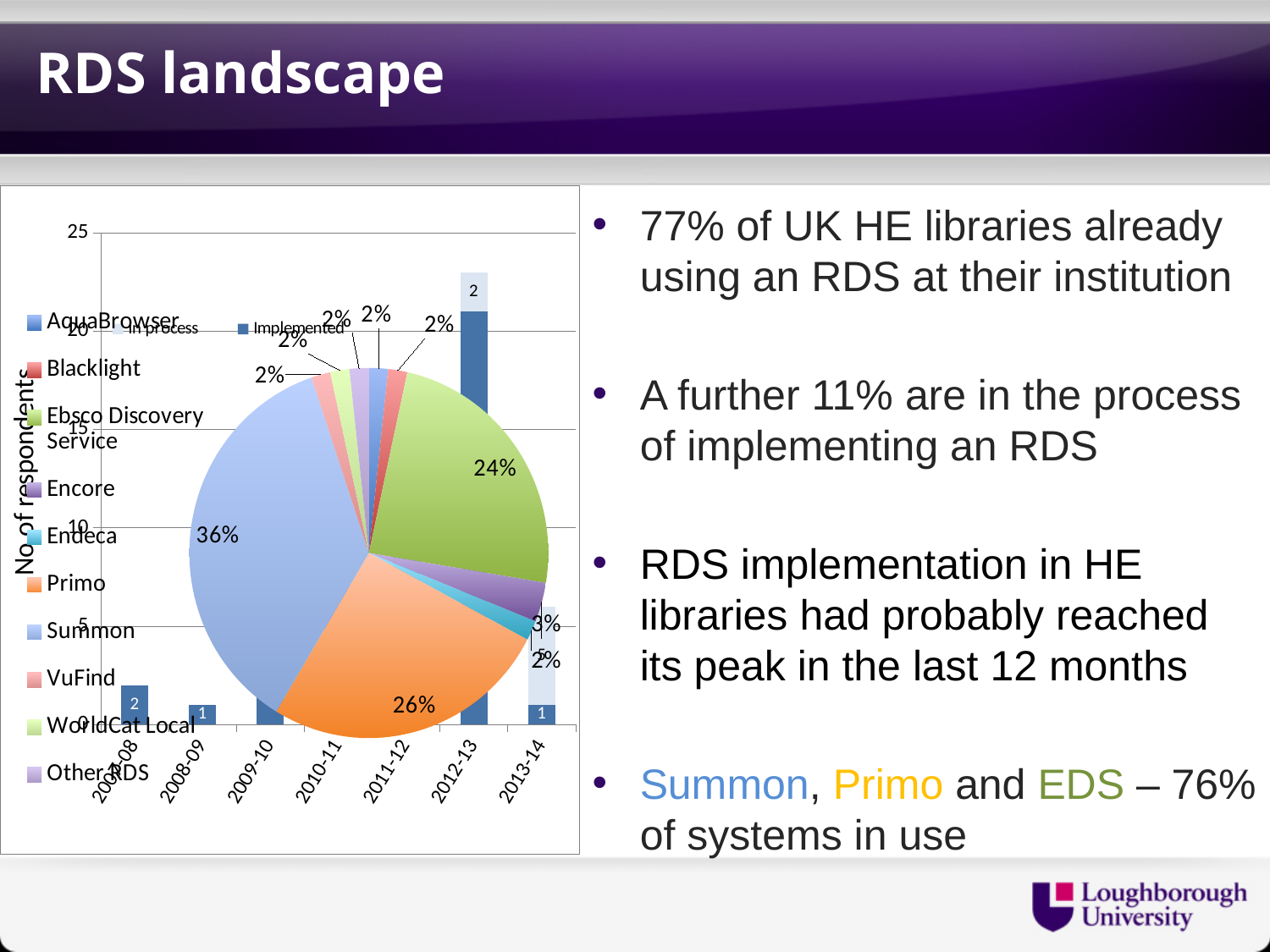
In the bar chart with year categories, how many year categories are on the x axis? 7 What kind of chart is the chart with percentage labels on the left of the slide? pie chart In the pie chart, what is the share of the largest slice? 36% How many entries does the pie chart's legend list? 10 In the pie chart, what share is shown for Summon (the light blue slice)? 36% In the pie chart, how many percentage points larger is the 36% slice than the 26% slice? 10 In the pie chart, what share is shown for Primo (the orange slice)? 26% In the bar chart with year categories, how many series does the legend list? 2 In the pie chart, which slice is larger: the orange Primo slice or the green Ebsco Discovery Service slice? Primo What kind of chart is the chart with the year categories (2007-08 to 2013-14) on the left of the slide? bar chart In the pie chart, what share is shown for Ebsco Discovery Service (the green slice)? 24% In the bar chart with year categories, which year has the tallest bar? 2012-13